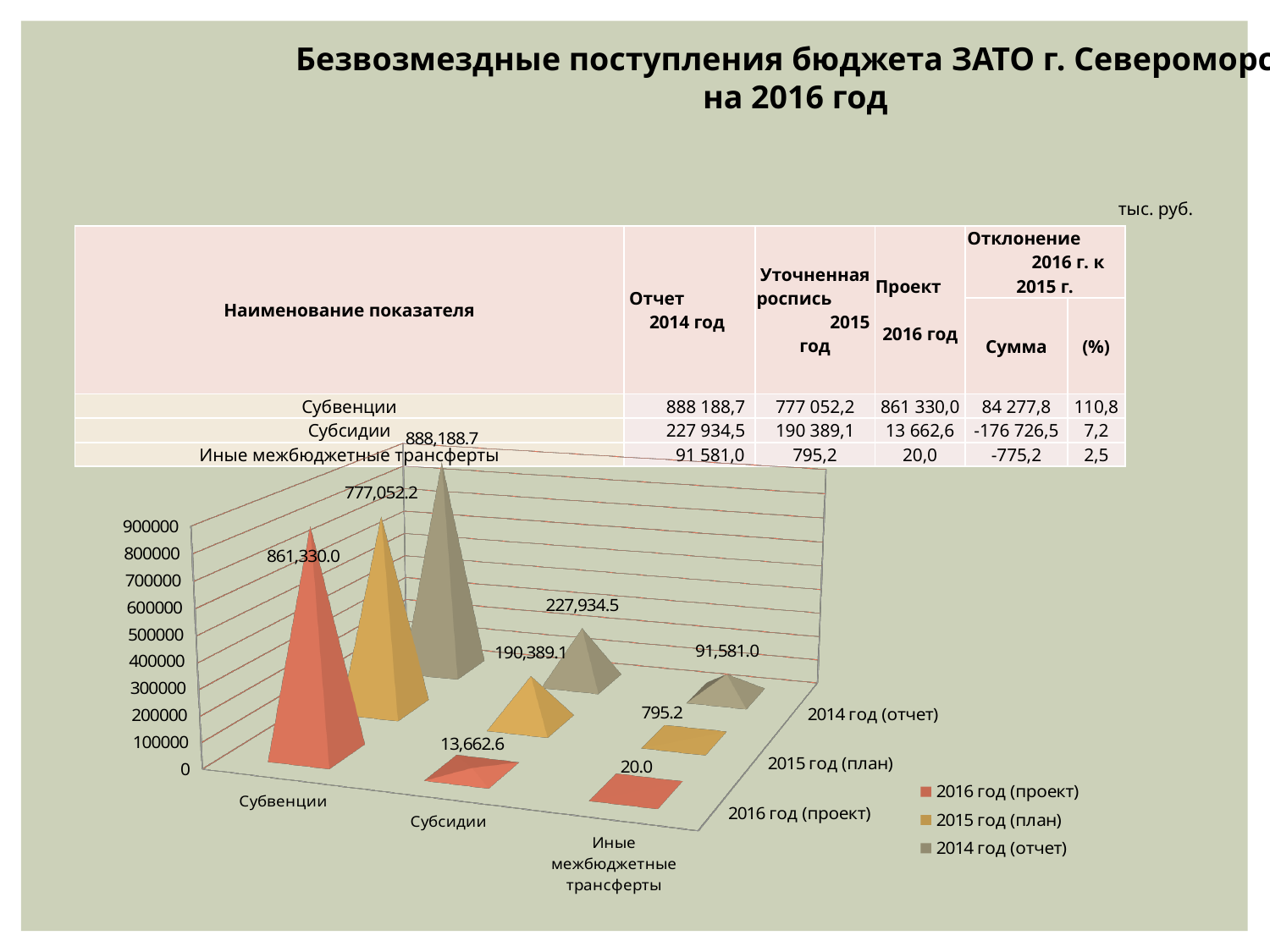
How many series does the chart legend list? 3 What is the value for Субсидии in the 2014 год (отчет) series? 227,934.5 Which series is shown in red on the chart? 2016 год (проект) Which category has the lowest value in the 2016 год (проект) series? Иные межбюджетные трансферты What is the value for Иные межбюджетные трансферты in the 2015 год (план) series? 795.2 What is the value for Субвенции in the 2014 год (отчет) series? 888,188.7 What is the value for Субвенции in the 2016 год (проект) series? 861,330.0 What is the difference between the 2014 год (отчет) and 2015 год (план) values for Субсидии? 37,545.4 Is the value for Субсидии in the 2014 год (отчет) series greater or less than 300000? less How many categories are shown on the chart's category axis? 3 Which is larger for Субвенции: the 2016 год (проект) value or the 2015 год (план) value? 2016 год (проект) Which category has the highest value in the 2015 год (план) series? Субвенции